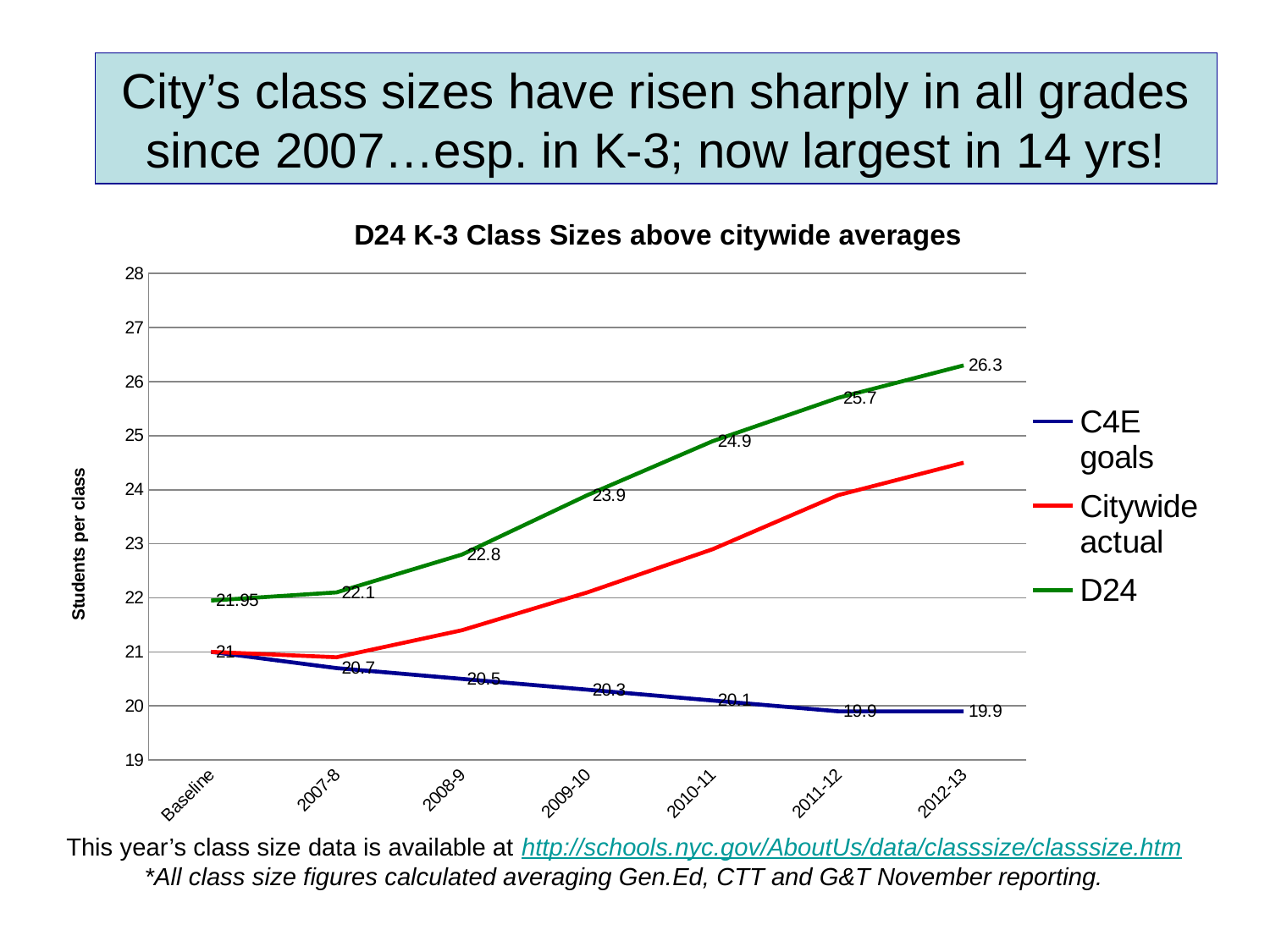
Does the D24 series rise or fall from Baseline to 2012-13? rise How many series does the legend list? 3 What is the difference between the D24 value and the C4E goals value in 2012-13? 6.4 What is the title of the chart? D24 K-3 Class Sizes above citywide averages What is the C4E goals value for 2008-9? 20.5 Is the Citywide actual value for 2012-13 greater or less than 24? greater In which year does the D24 series reach its highest value? 2012-13 What is the D24 value for 2009-10? 23.9 How many points are plotted along the x axis for each series? 7 What type of chart is shown on the slide? line chart What is the D24 value for 2012-13? 26.3 What is the C4E goals value at Baseline? 21